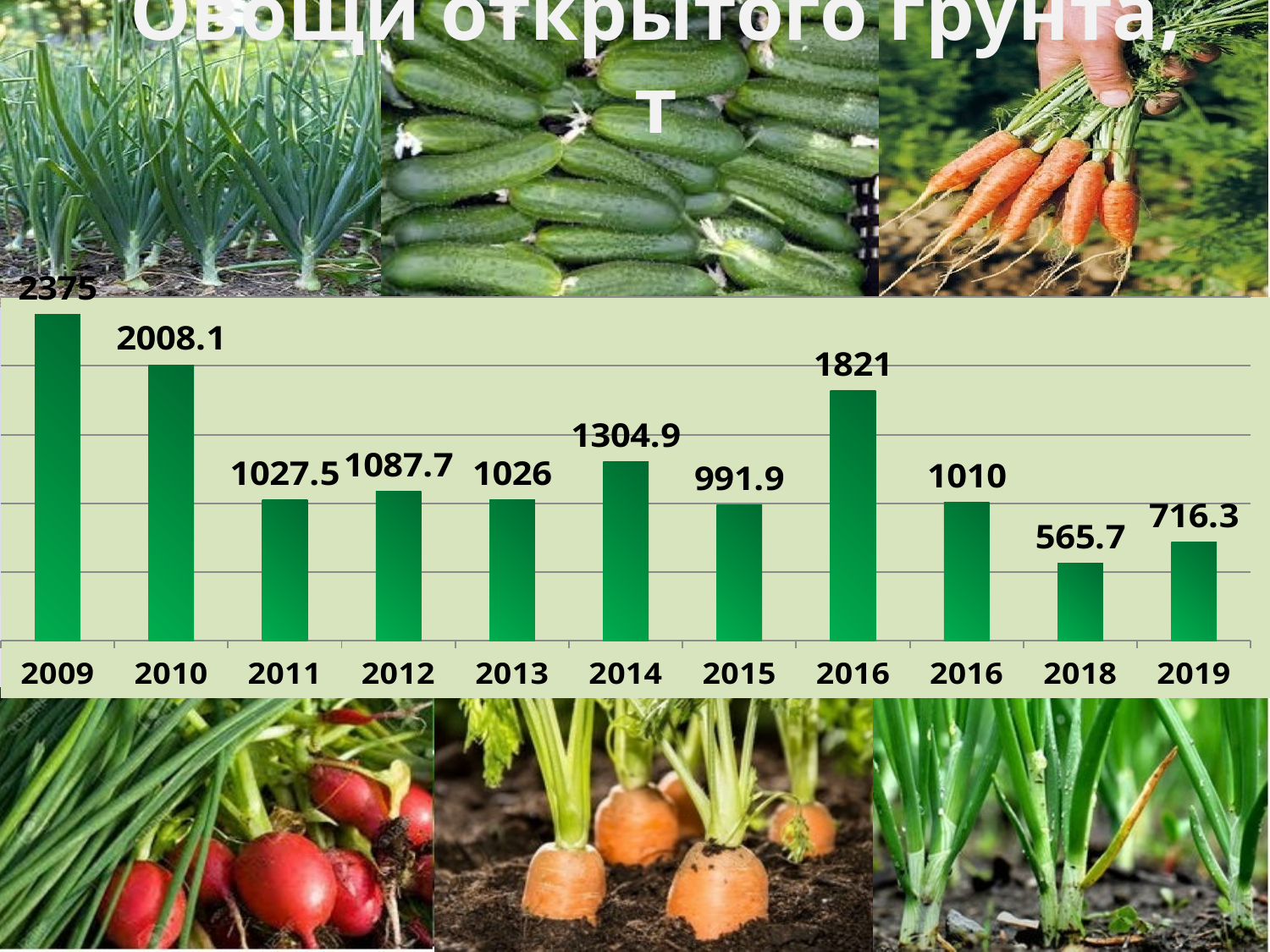
Which year has the lowest value? 2018 What is the value for 2010? 2008.1 What kind of chart is shown on the slide? bar chart Which is larger, the value for 2011 or the value for 2012? 2012 What is the value for 2014? 1304.9 How many bars are shown in the chart? 11 What is the difference between the values for 2009 and 2010? 366.9 What is the difference between the values for 2019 and 2018? 150.6 What is the value for 2009? 2375 What is the value for 2018? 565.7 What is the value for 2015? 991.9 Which year has the highest value? 2009